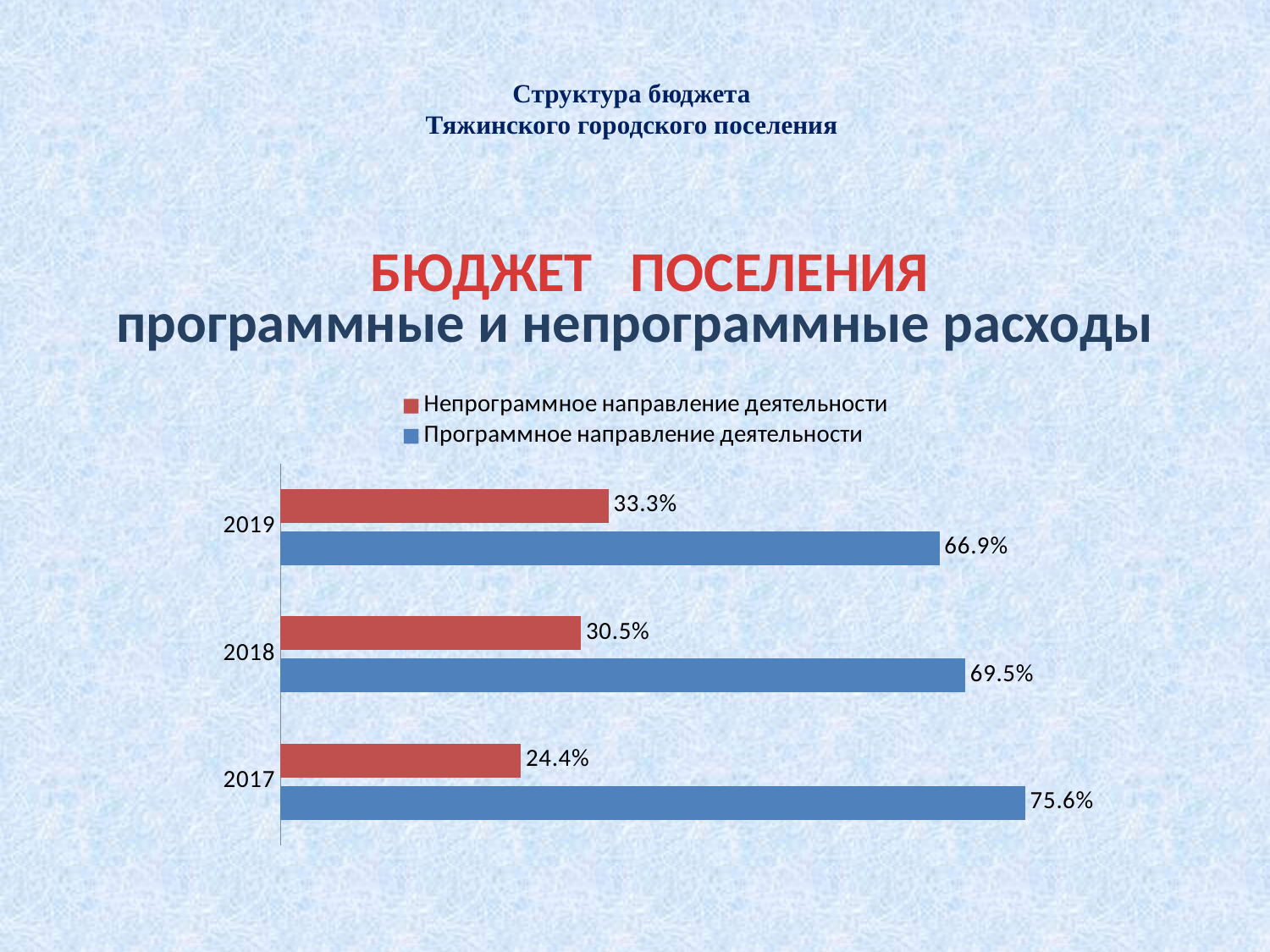
How many series does the legend list? 2 What is the value for Программное направление деятельности in 2019? 66.9% What is the value for Непрограммное направление деятельности in 2018? 30.5% What is the difference between the Программное and Непрограммное values in 2018? 39.0% In which year is the value for Непрограммное направление деятельности the lowest? 2017 What is the value for Непрограммное направление деятельности in 2019? 33.3% Which is larger in 2019: Программное направление деятельности or Непрограммное направление деятельности? Программное направление деятельности Which colour represents Непрограммное направление деятельности in the legend? Red In which year is the value for Программное направление деятельности the highest? 2017 How many years are shown on the chart? 3 What kind of chart is shown on the slide? Bar chart What is the value for Программное направление деятельности in 2017? 75.6%